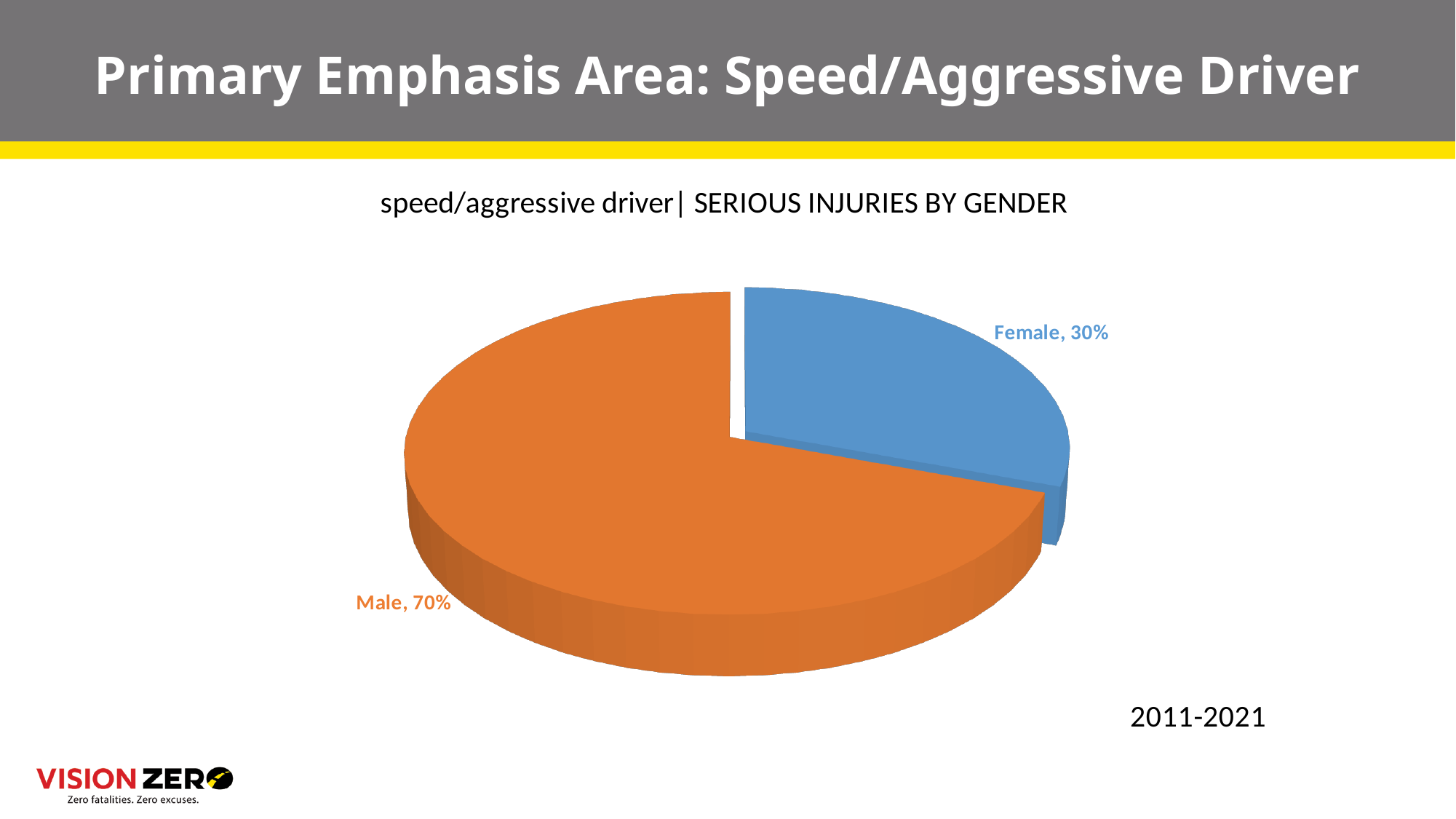
What is the difference in percentage points between the Male and Female shares? 40 Which gender has the smallest share of serious injuries? Female What kind of chart is shown on the slide? Pie chart What is the title of the chart? speed/aggressive driver| SERIOUS INJURIES BY GENDER Which is larger, the Male share or the Female share? Male How many slices does the pie chart have? 2 What colour is the Female slice? Blue Which gender has the largest share of serious injuries? Male What time period does the chart cover? 2011-2021 What share of serious injuries is attributed to Male? 70% What share of serious injuries is attributed to Female? 30%